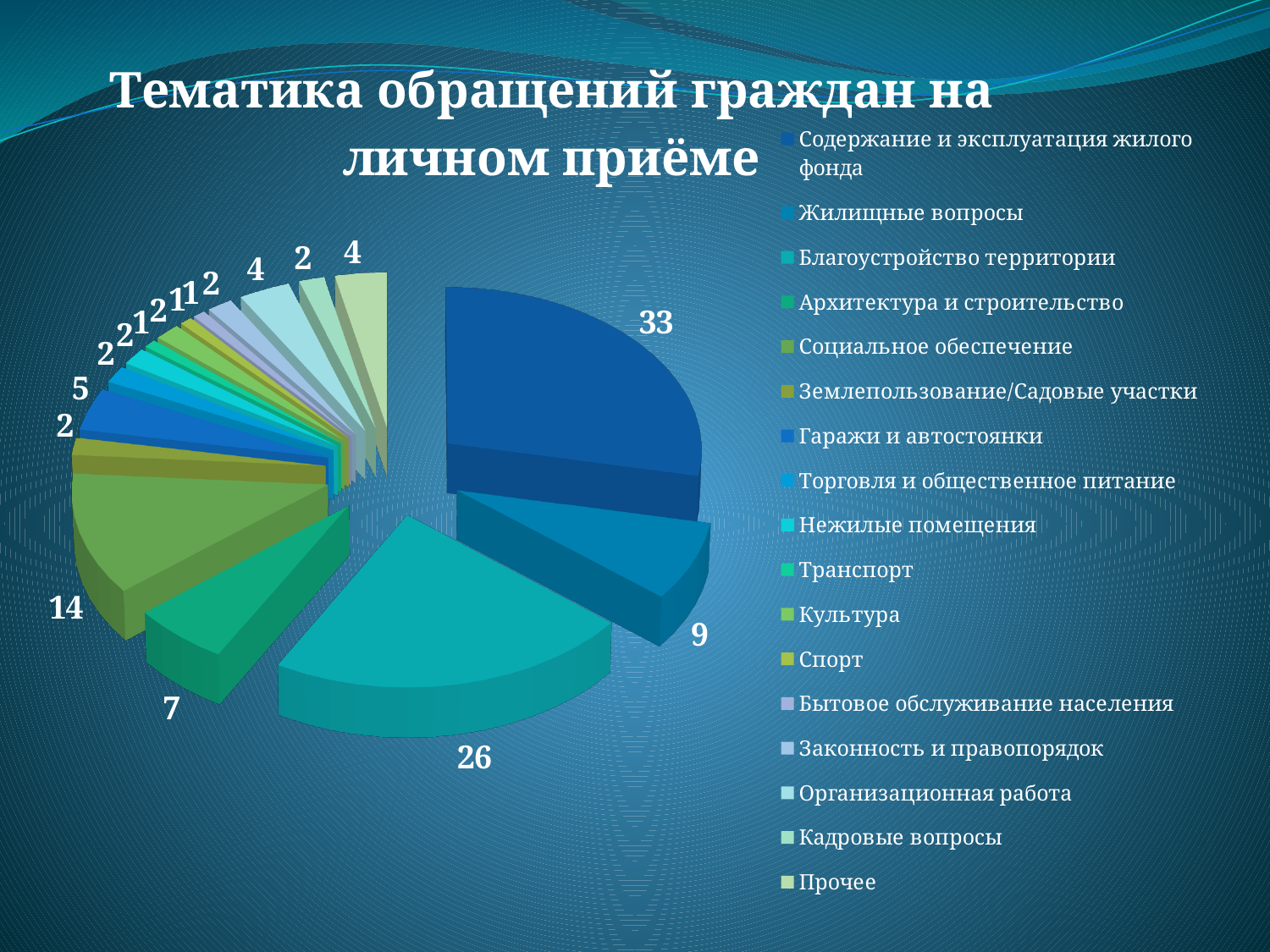
What is the title of the chart? Тематика обращений граждан на личном приёме What is the value for Архитектура и строительство? 7 What is the value for Социальное обеспечение? 14 What is the value for Содержание и эксплуатация жилого фонда? 33 Which category has the largest slice of the pie? Содержание и эксплуатация жилого фонда How many categories does the legend list? 17 What is the value for Благоустройство территории? 26 What is the difference between the values for Содержание и эксплуатация жилого фонда and Благоустройство территории? 7 Which is larger, the value for Социальное обеспечение or the value for Жилищные вопросы? Социальное обеспечение What is the difference between the values for Социальное обеспечение and Архитектура и строительство? 7 What is the value for Жилищные вопросы? 9 What kind of chart is shown on the slide? pie chart